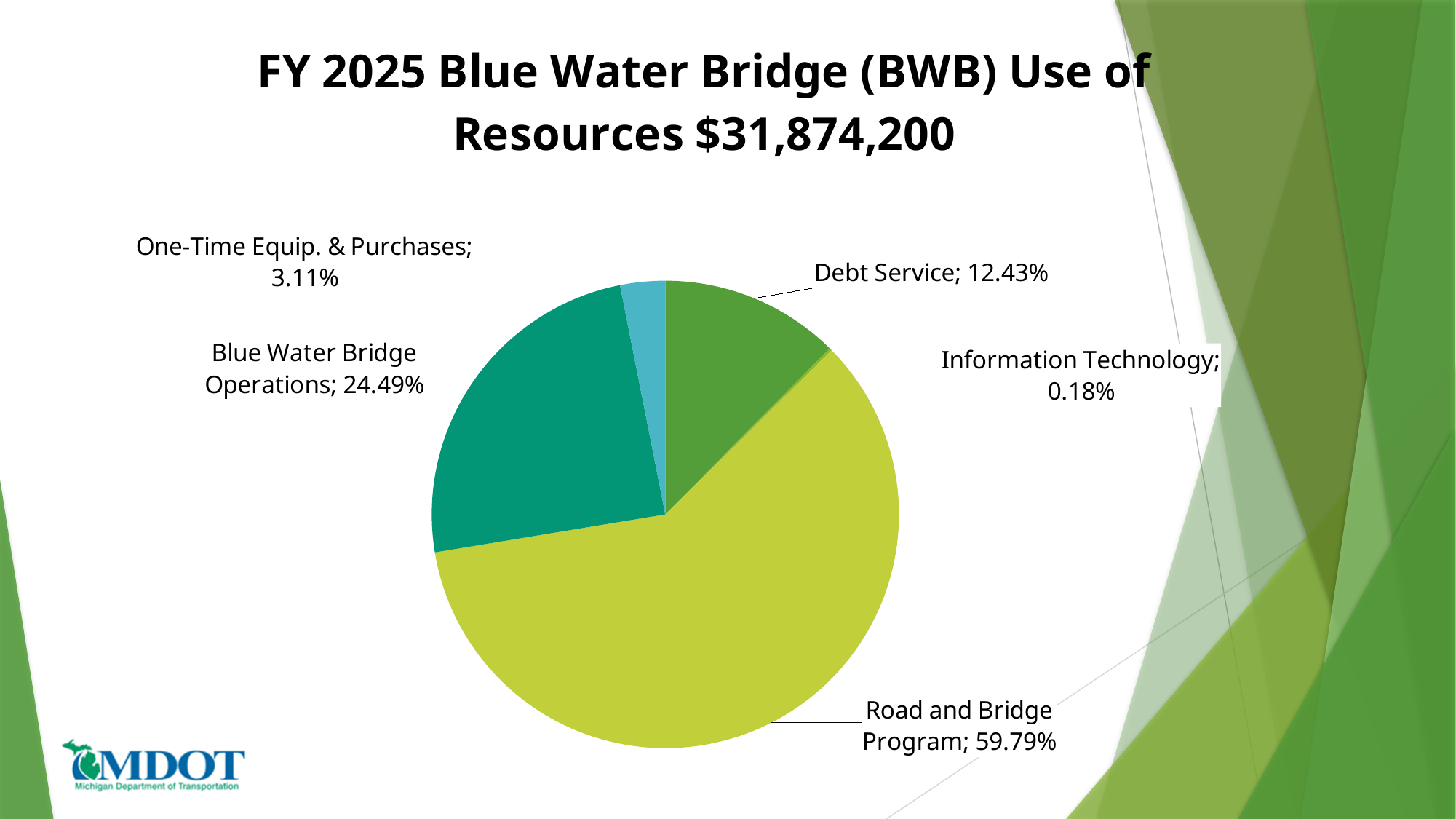
What is the value for Debt Service? 12.43% What share of resources goes to the Road and Bridge Program? 59.79% Which is larger, Debt Service or One-Time Equip. & Purchases? Debt Service What percentage is shown for Blue Water Bridge Operations? 24.49% What percentage is labelled for One-Time Equip. & Purchases? 3.11% What kind of chart is shown on the slide? Pie chart What total dollar amount is given in the chart title? $31,874,200 How many categories are shown in the pie chart? 5 What share is shown for Information Technology? 0.18% What is the difference in percentage points between Blue Water Bridge Operations and Debt Service? 12.06 Which category has the smallest slice of the pie? Information Technology Which category has the largest slice of the pie? Road and Bridge Program